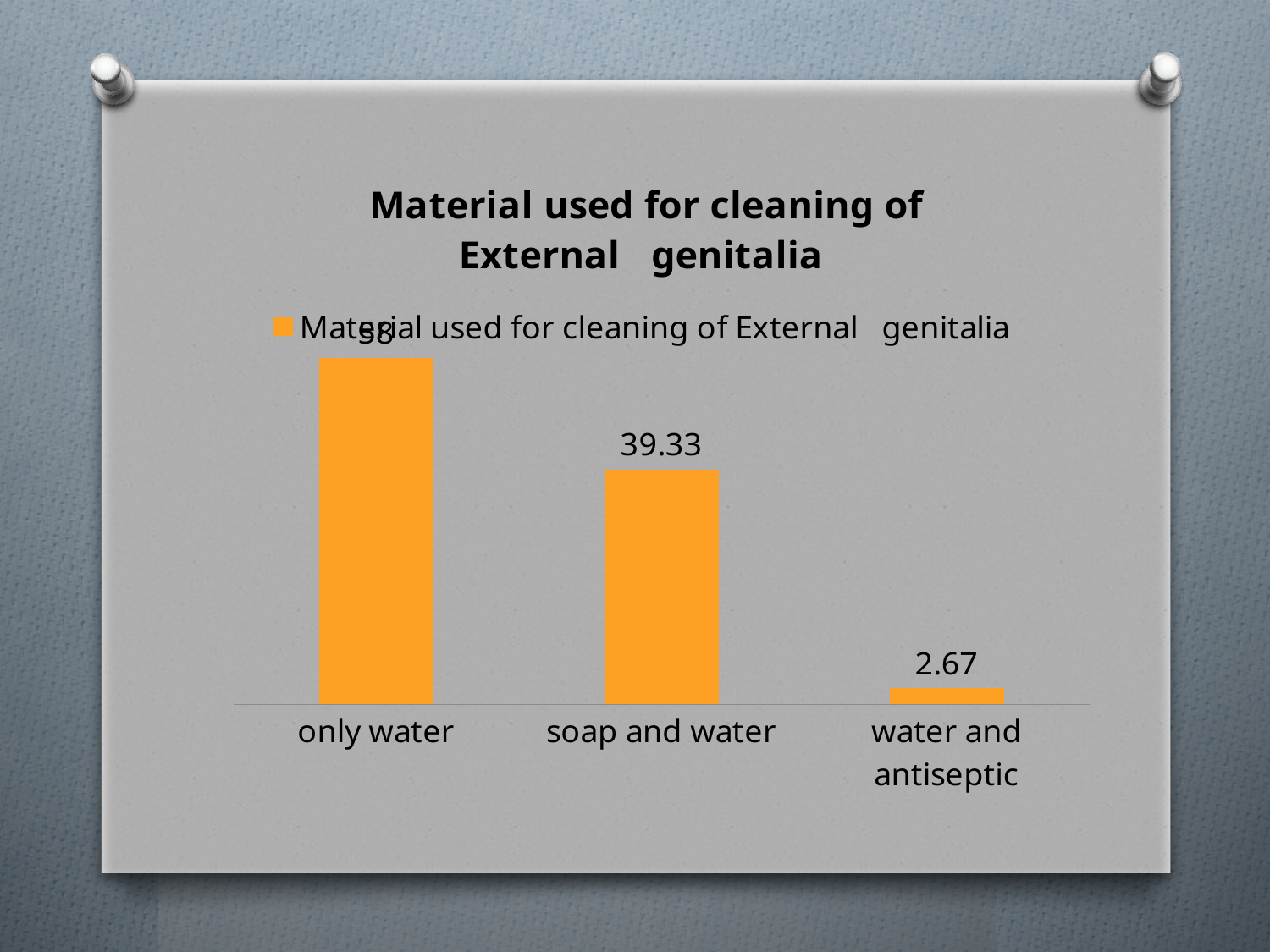
How many categories are shown on the x axis? 3 What is the value for soap and water? 39.33 How many series does the legend list? 1 What is the title of the chart? Material used for cleaning of External genitalia What kind of chart is shown on the slide? bar chart Do the values rise or fall from left to right along the x axis? fall Which is larger, the value for soap and water or the value for water and antiseptic? soap and water What is the value for water and antiseptic? 2.67 Which category has the highest value? only water Which category has the lowest value? water and antiseptic Which is larger, the value for only water or the value for soap and water? only water What is the difference between the values for soap and water and water and antiseptic? 36.66